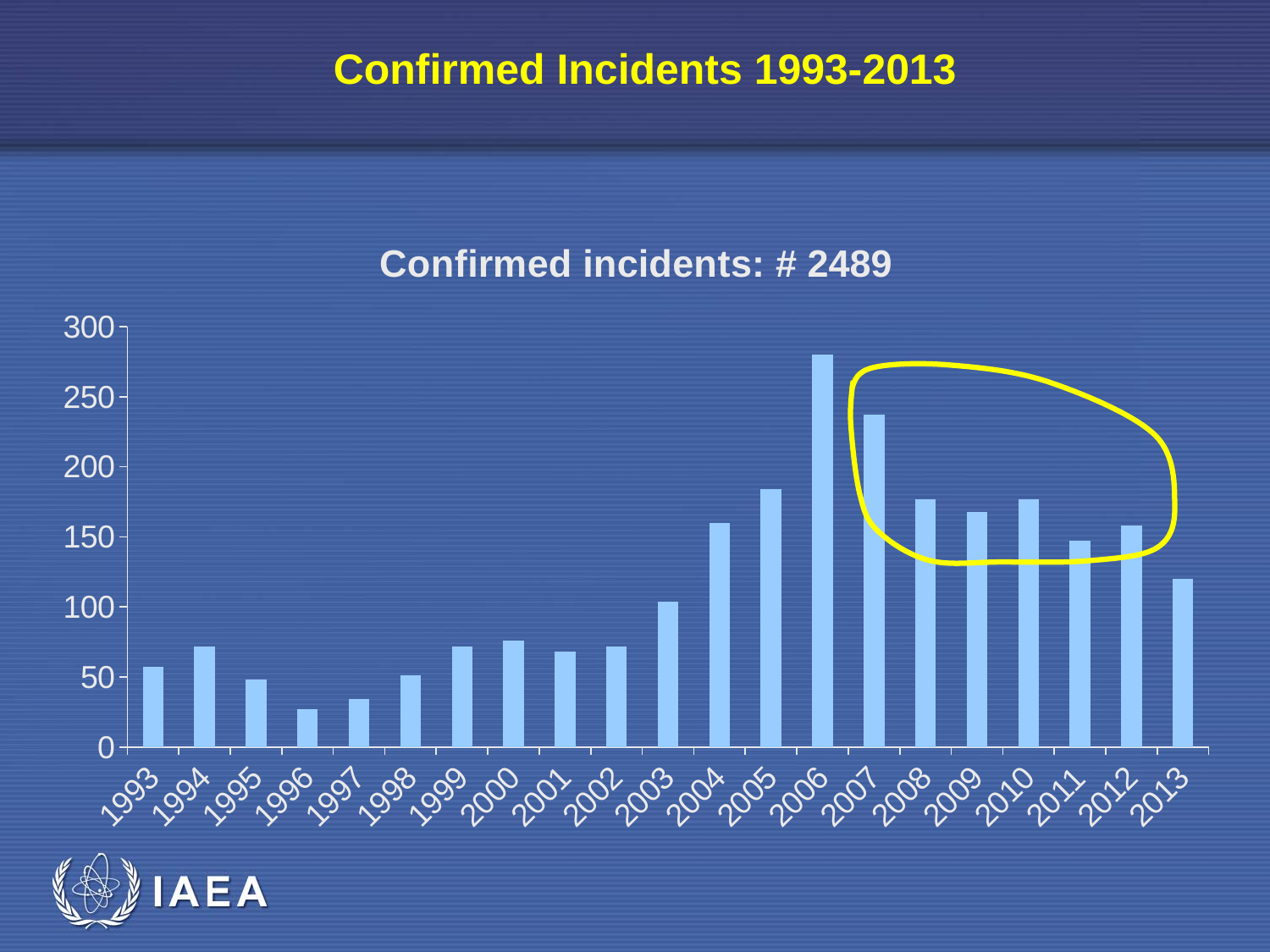
What kind of chart is shown on the slide? Bar chart Is the value for 2006 greater or less than 250? greater What total number of confirmed incidents is stated above the chart? 2489 Is the value for 1996 greater or less than 50? less Which year has the lowest number of confirmed incidents? 1996 How many years are shown on the x axis of the chart? 21 Do the values rise or fall from 2006 to 2013? fall Is the value for 2013 greater or less than 150? less Which year has the larger value, 1997 or 2004? 2004 Which year has the larger value, 2005 or 2007? 2007 Which year has the highest number of confirmed incidents? 2006